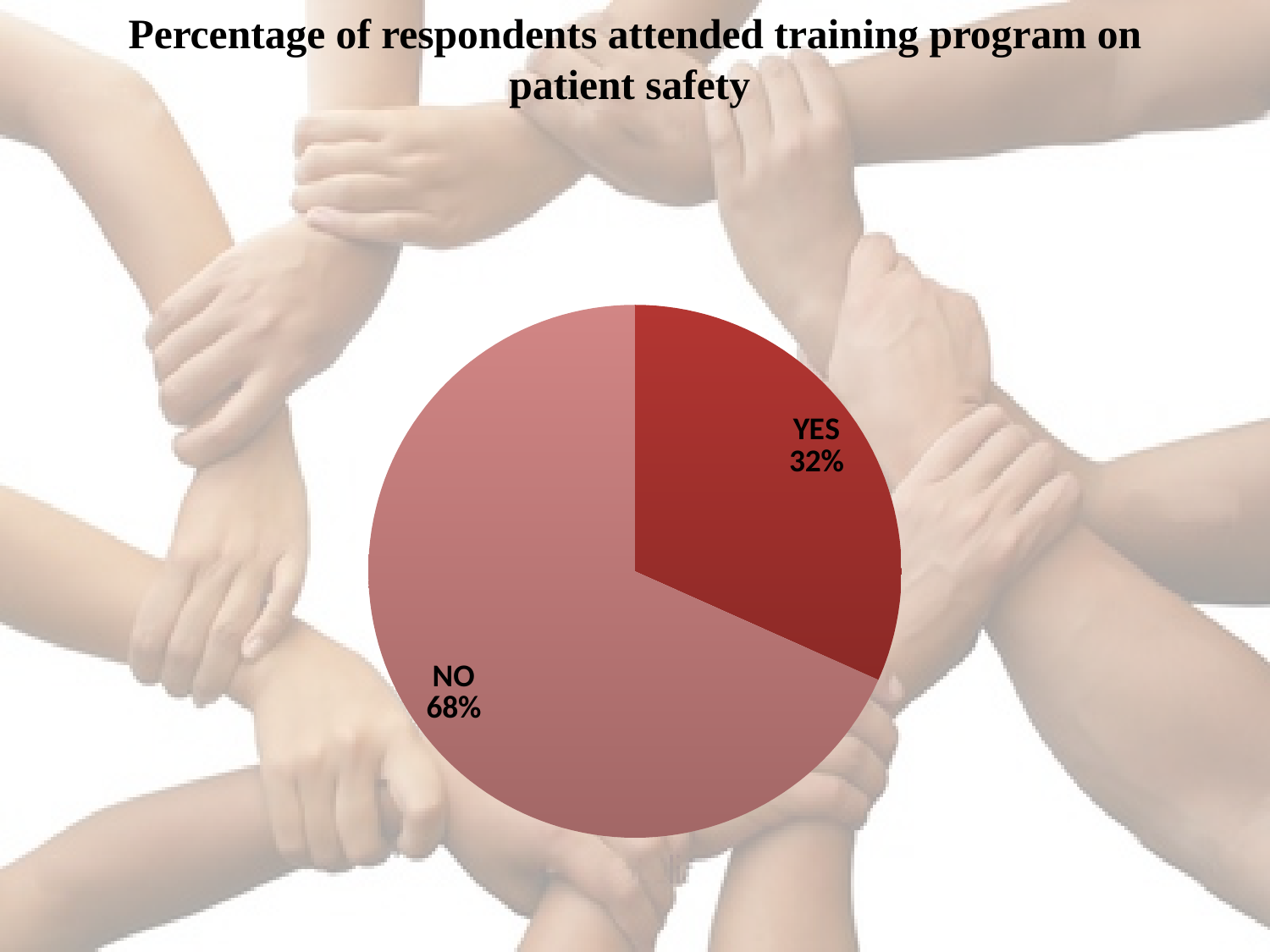
Which slice of the pie is the largest? NO Which is larger, the YES slice or the NO slice? NO What share of the pie does the YES slice represent? 32% What percentage of respondents answered YES to attending a training program on patient safety? 32% What is the difference in percentage points between the NO and YES slices? 36% How many slices does the pie chart have? 2 Which slice is shown in the darker red colour? YES What is the title of the chart? Percentage of respondents attended training program on patient safety Which slice of the pie is the smallest? YES What percentage of respondents answered NO? 68% What kind of chart is shown on the slide? Pie chart